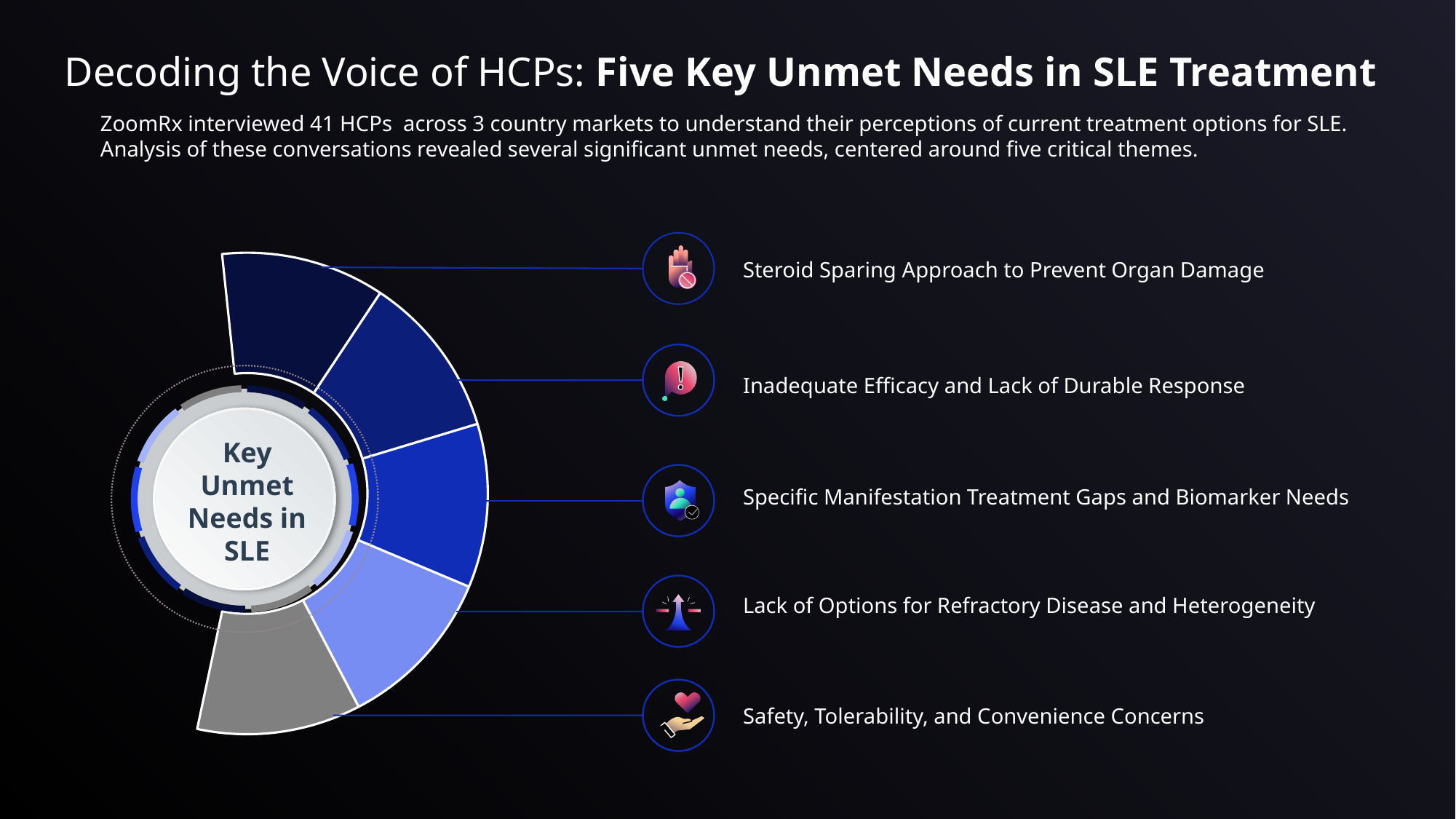
Which unmet need is linked to the grey (bottom) segment of the semicircular diagram? Safety, Tolerability, and Convenience Concerns How many segments does the semicircular diagram on the left have? 5 How many HCPs did ZoomRx interview according to the slide? 41 What text appears in the centre of the semicircular diagram? Key Unmet Needs in SLE Across how many country markets were the HCPs interviewed? 3